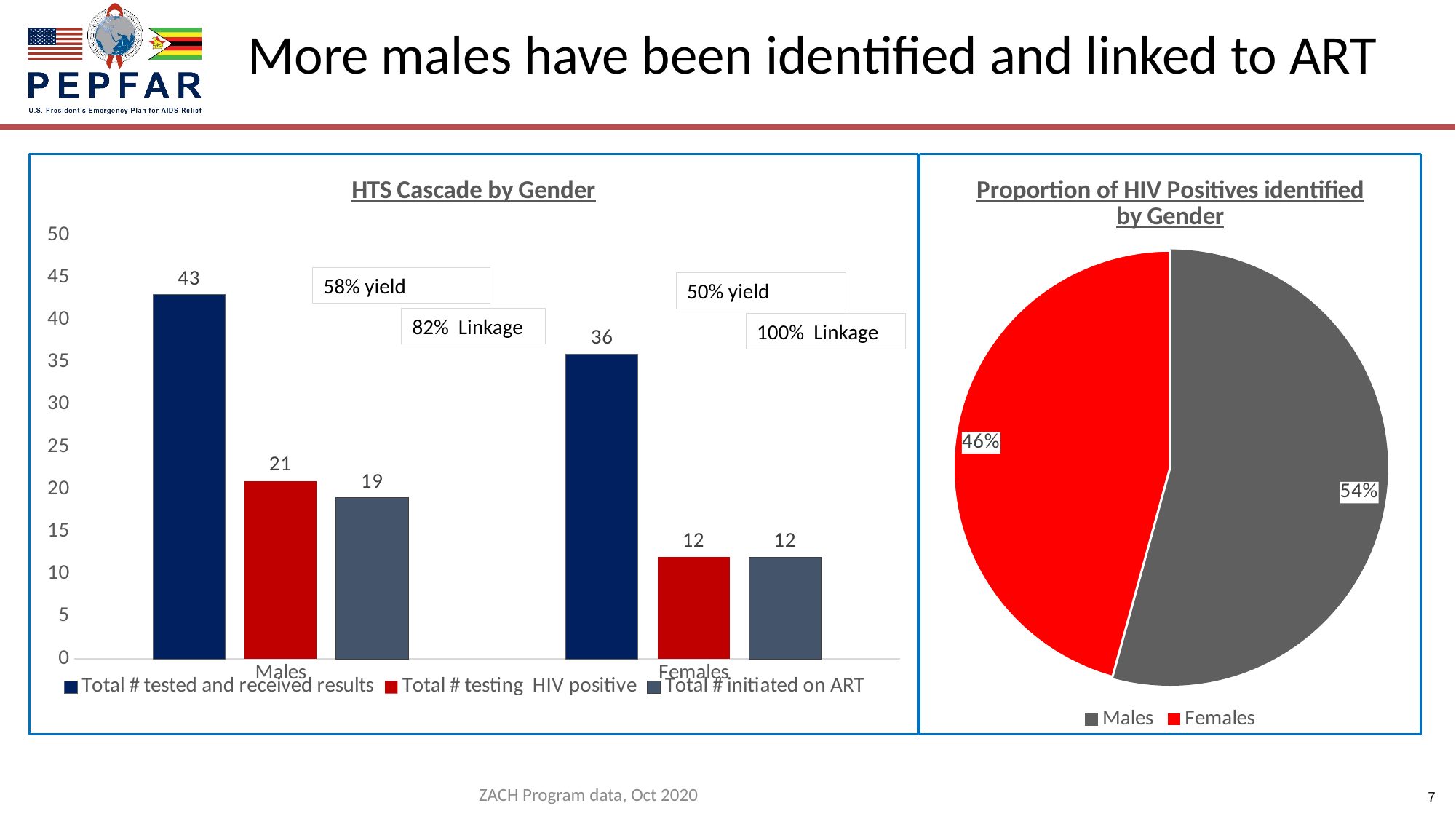
In the 'HTS Cascade by Gender' chart, what is the difference between 'Total # tested and received results' for Males and for Females? 7 In the 'HTS Cascade by Gender' chart, what is the value of 'Total # testing HIV positive' for Females? 12 In the 'HTS Cascade by Gender' chart, which gender has the higher value for 'Total # testing HIV positive'? Males In the 'HTS Cascade by Gender' chart, how many series does the legend list? 3 In the 'Proportion of HIV Positives identified by Gender' chart, what share of the pie is Females? 46% In the 'Proportion of HIV Positives identified by Gender' chart, what share of the pie is Males? 54% In the 'HTS Cascade by Gender' chart, how many categories are shown on the x axis? 2 What kind of chart is 'HTS Cascade by Gender'? Bar chart In the 'HTS Cascade by Gender' chart, what is the value of 'Total # tested and received results' for Males? 43 In the 'HTS Cascade by Gender' chart, what is the value of 'Total # initiated on ART' for Males? 19 What kind of chart is 'Proportion of HIV Positives identified by Gender'? Pie chart In the 'Proportion of HIV Positives identified by Gender' chart, what colour is the Females slice? Red